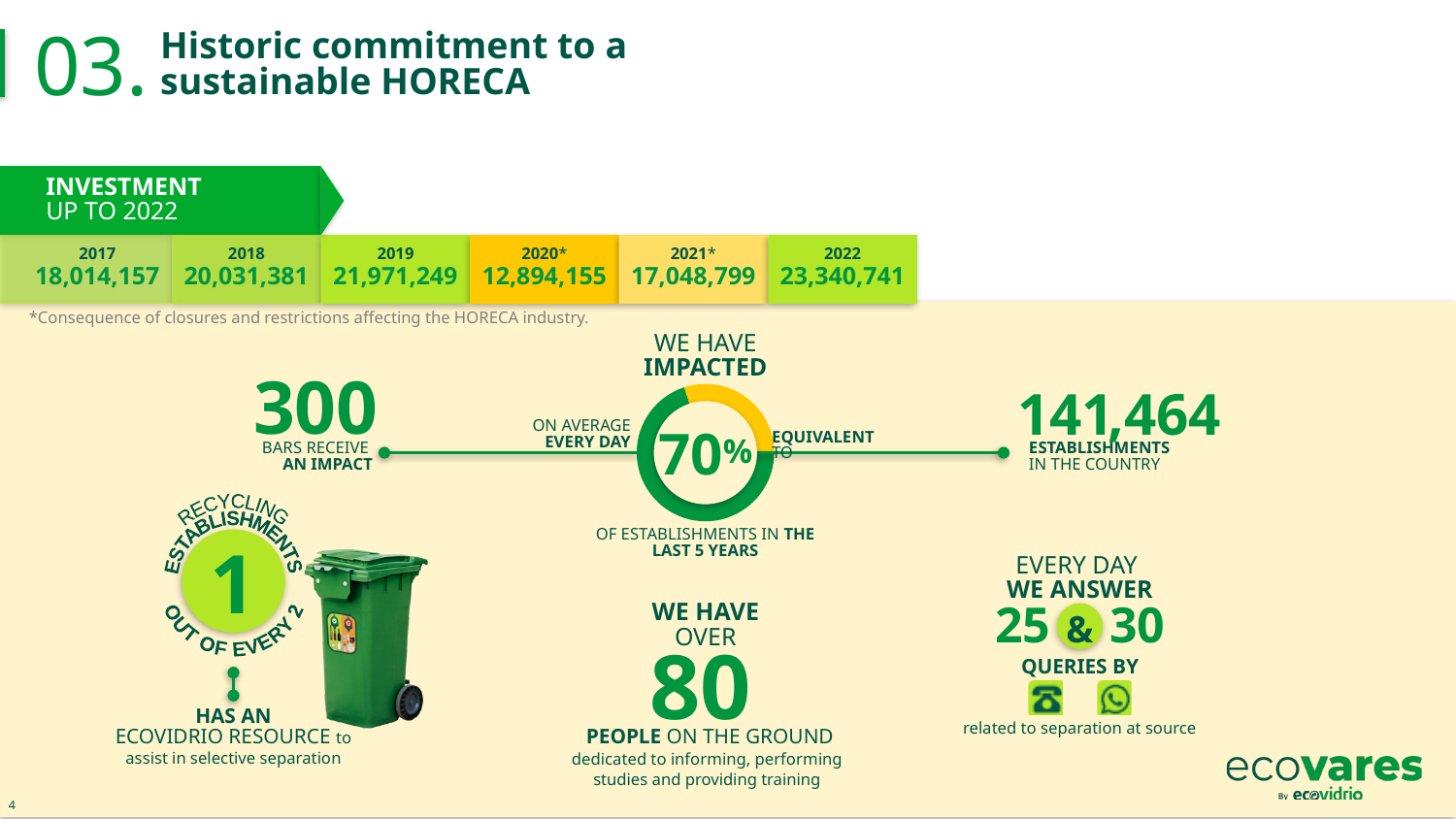
How many segments does the donut chart have? 2 In the investment timeline, is the investment for 2019 larger or smaller than for 2021? Larger In the investment timeline, what was the investment in 2022? 23,340,741 Which colour is used for the larger segment of the donut chart? Green What kind of chart is shown in the centre of the slide under 'WE HAVE IMPACTED'? Donut (pie) chart According to the donut chart, what share of establishments have been impacted in the last 5 years? 70% Is the value shown in the donut chart greater or less than 50%? greater In the investment timeline, which year has the lowest investment? 2020 What share of the donut chart is not covered by the 70% segment? 30% What percentage is printed in the centre of the donut chart? 70% In the investment timeline, which year has the highest investment? 2022 Which colour is used for the smaller segment of the donut chart? Yellow